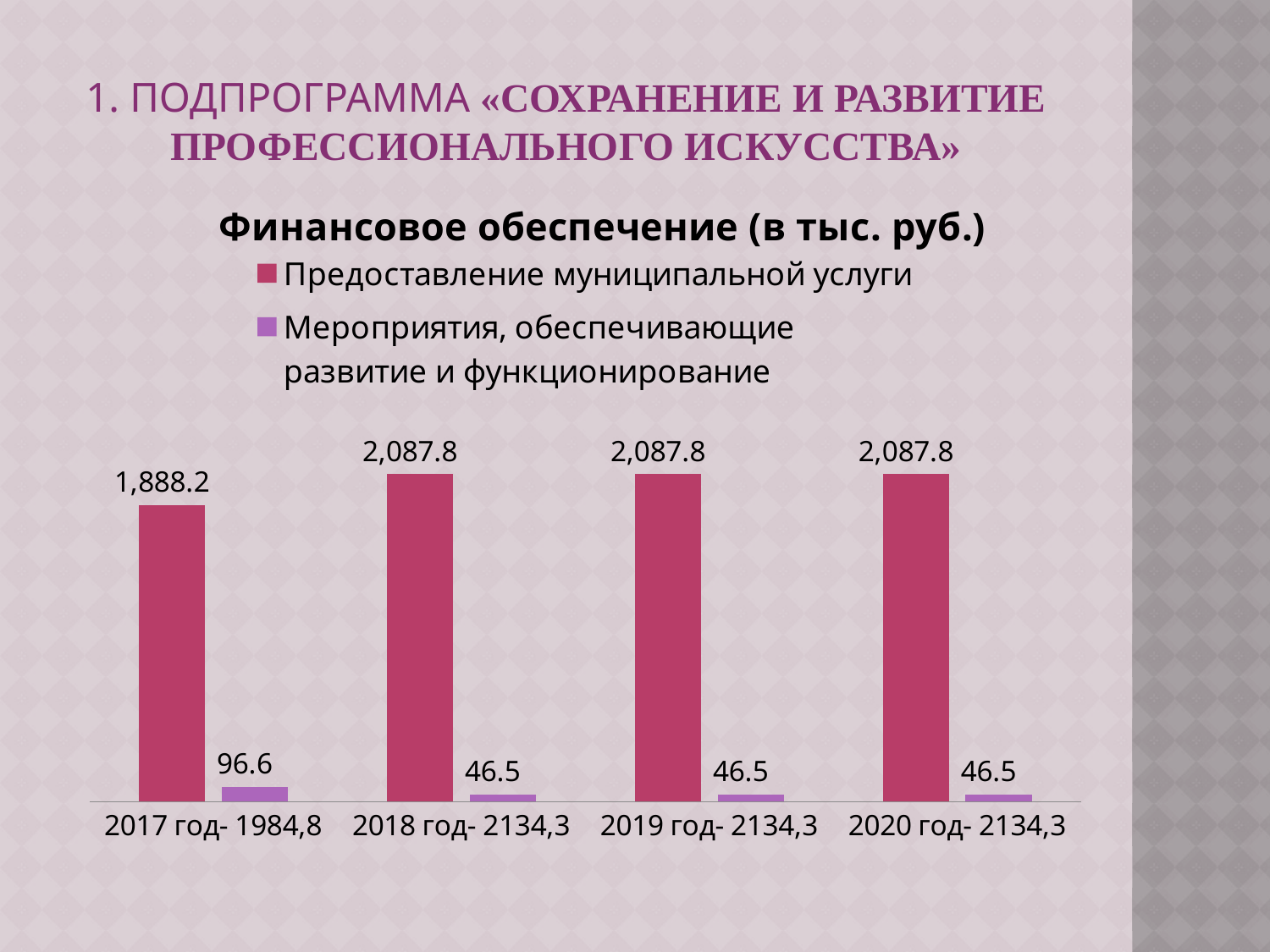
What kind of chart is shown on the slide? Bar chart What is the value for "Предоставление муниципальной услуги" in "2019 год- 2134,3"? 2,087.8 How many series does the legend list? 2 Which is larger in "2019 год- 2134,3": "Предоставление муниципальной услуги" or "Мероприятия, обеспечивающие развитие и функционирование"? Предоставление муниципальной услуги In which category is the value for "Предоставление муниципальной услуги" lowest? 2017 год- 1984,8 What is the difference between the "Предоставление муниципальной услуги" values for "2018 год- 2134,3" and "2017 год- 1984,8"? 199.6 How many categories are shown on the x axis? 4 What is the difference between the "Мероприятия, обеспечивающие развитие и функционирование" values for "2017 год- 1984,8" and "2018 год- 2134,3"? 50.1 What is the value for "Предоставление муниципальной услуги" in "2017 год- 1984,8"? 1,888.2 What is the value for "Мероприятия, обеспечивающие развитие и функционирование" in "2017 год- 1984,8"? 96.6 In which category is the value for "Мероприятия, обеспечивающие развитие и функционирование" highest? 2017 год- 1984,8 What is the value for "Мероприятия, обеспечивающие развитие и функционирование" in "2020 год- 2134,3"? 46.5